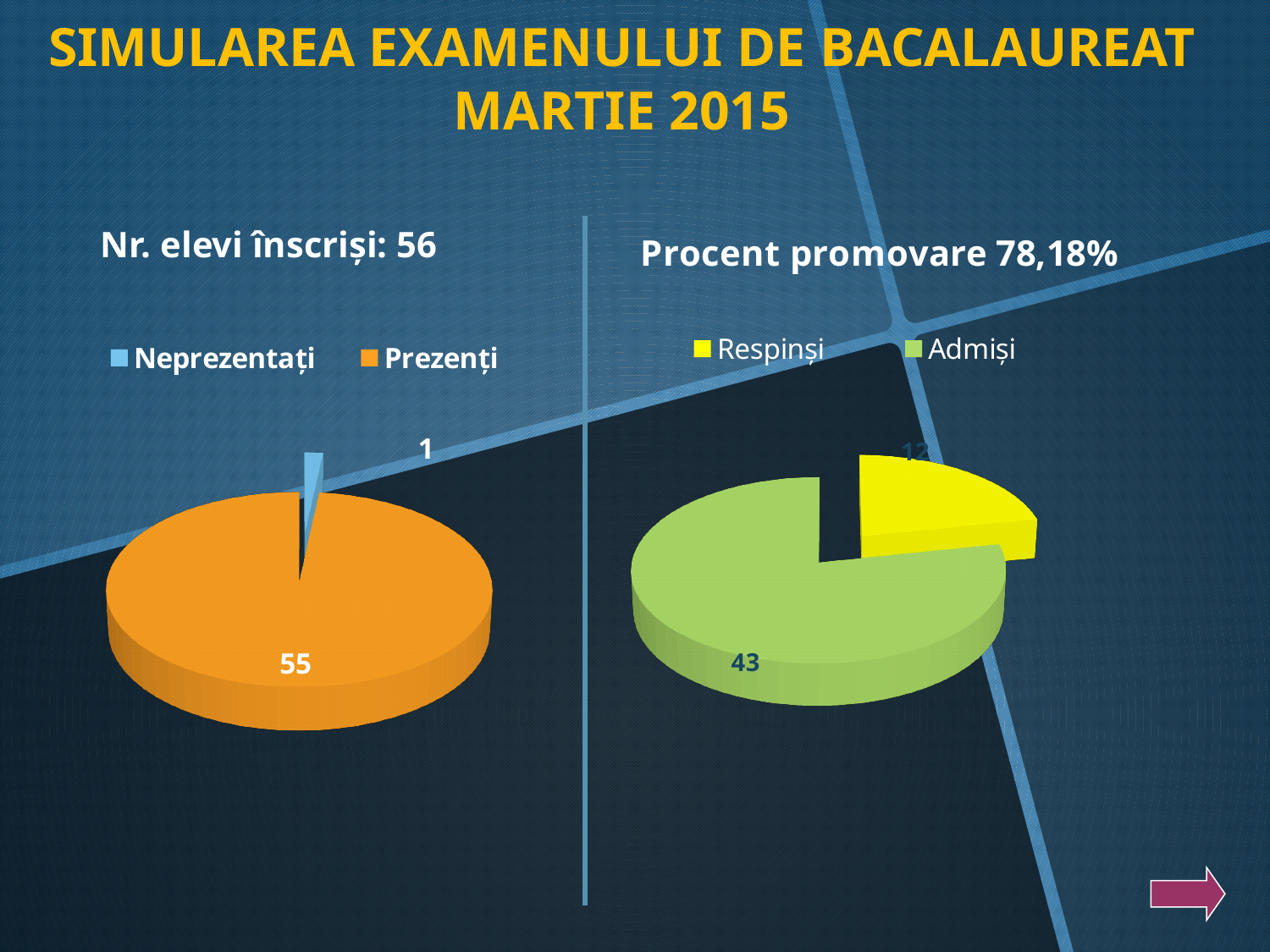
In the right pie chart (Procent promovare 78,18%), which category has the largest slice? Admiși In the right pie chart (Procent promovare 78,18%), what is the value for Admiși? 43 In the right pie chart (Procent promovare 78,18%), what is the difference between Admiși and Respinși? 31 What type of chart is shown on the left side of the slide? Pie chart In the right pie chart (Procent promovare 78,18%), what is the value for Respinși? 12 In the right pie chart (Procent promovare 78,18%), what is the total of the two slices? 55 In the left pie chart (Nr. elevi înscriși: 56), what is the difference between Prezenți and Neprezentați? 54 In the left pie chart (Nr. elevi înscriși: 56), what is the value for Prezenți? 55 In the right pie chart (Procent promovare 78,18%), what share of the pie does Admiși represent? 78,18% In the left pie chart (Nr. elevi înscriși: 56), which category has the smallest slice? Neprezentați In the left pie chart (Nr. elevi înscriși: 56), what is the value for Neprezentați? 1 How many entries does the legend of the right chart (Procent promovare 78,18%) list? 2